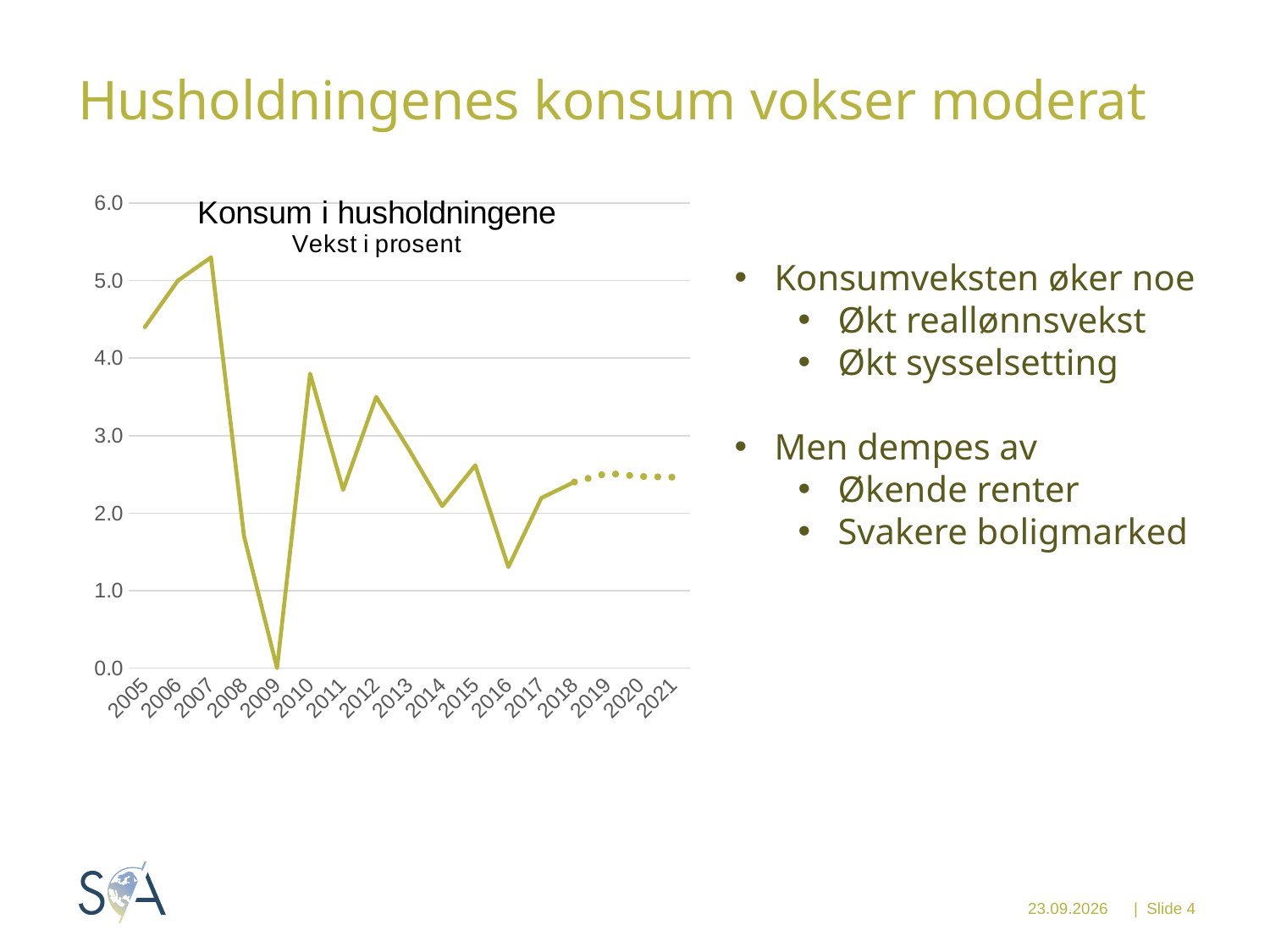
Which year has the highest value in the chart? 2007 Which year has the lowest value in the chart? 2009 Which year has the larger value, 2012 or 2014? 2012 Does the value rise or fall from 2007 to 2009? fall Is the value for 2007 greater or less than 5.0? greater Is the value for 2010 greater or less than 3.0? greater How many years are shown on the x axis of the chart? 17 Is the value for 2016 greater or less than 2.0? less What unit does the chart's subtitle say the values are in? Vekst i prosent What kind of chart is shown on the slide? line chart What is the title of the chart? Konsum i husholdningene